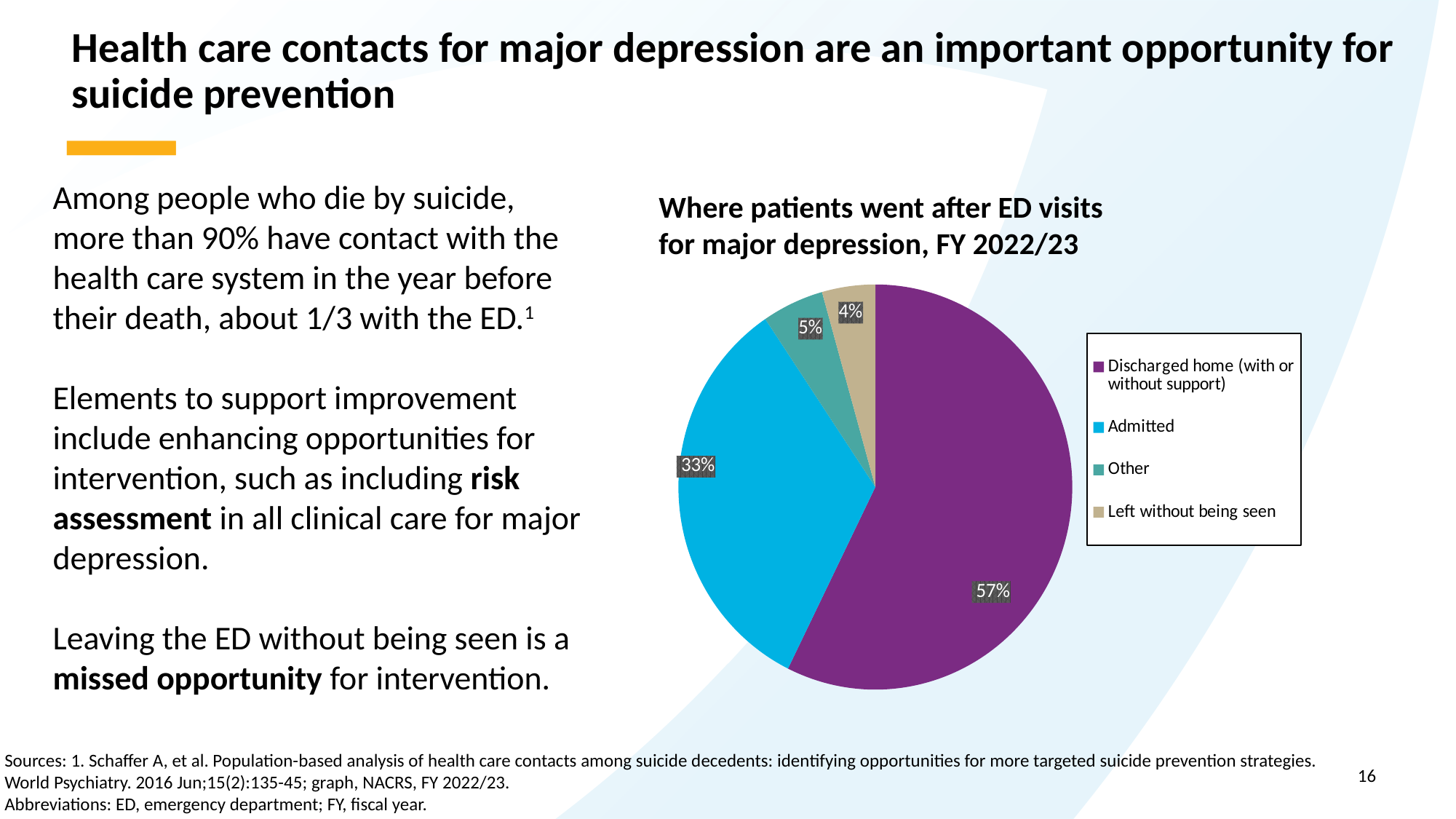
What percentage of patients fall into the 'Other' category? 5% What colour is the 'Admitted' slice in the pie chart? Blue How many categories does the pie chart show? 4 What percentage of patients left without being seen? 4% What kind of chart is shown on the slide? Pie chart What is the title of the pie chart? Where patients went after ED visits for major depression, FY 2022/23 Which is larger: the share for 'Other' or the share for 'Left without being seen'? Other What percentage of patients were discharged home (with or without support) after ED visits for major depression? 57% Which category has the largest share of the pie? Discharged home (with or without support) What percentage of patients were admitted after ED visits for major depression? 33% Which category has the smallest share of the pie? Left without being seen What is the difference in percentage points between the 'Discharged home' and 'Admitted' slices? 24 percentage points